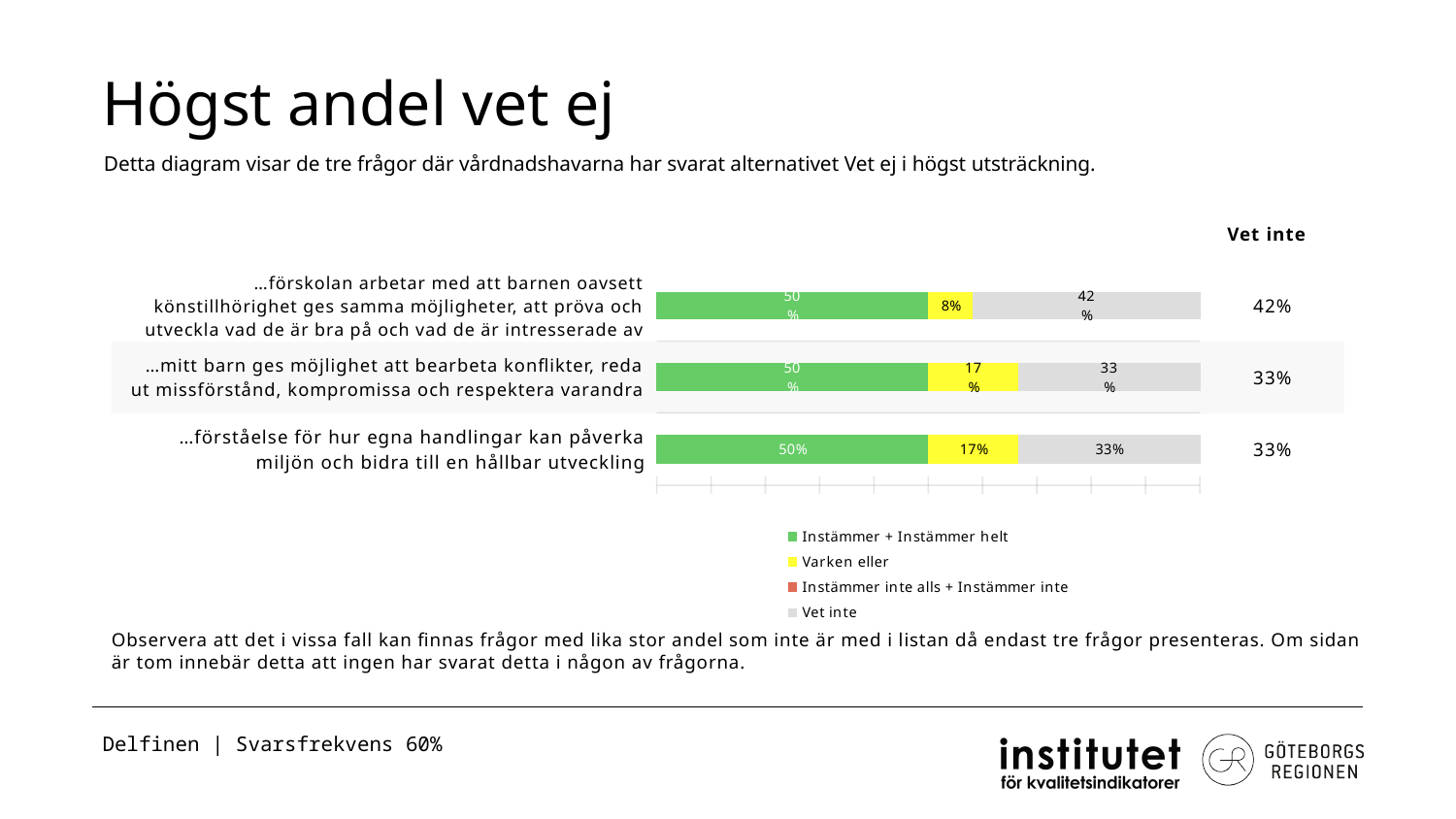
What type of chart is shown on the slide? Stacked bar chart What is the 'Vet inte' share for the top bar (…förskolan arbetar med att barnen oavsett könstillhörighet ges samma möjligheter…)? 42% What is the 'Varken eller' value for the top bar (…förskolan arbetar med att barnen oavsett könstillhörighet…)? 8% How many bars (questions) are plotted in the chart? 3 Which question has the highest 'Vet inte' share? …förskolan arbetar med att barnen oavsett könstillhörighet ges samma möjligheter, att pröva och utveckla vad de är bra på och vad de är intresserade av What is the difference between the 'Vet inte' share of the top bar and the middle bar? 9 percentage points What is the total of the three labelled segments in the middle bar (…mitt barn ges möjlighet att bearbeta konflikter…)? 100% Is the 'Varken eller' value larger for the top bar or the bottom bar? Bottom bar What is the heading of the column of values shown to the right of the bars? Vet inte How many series does the legend list? 4 What is the 'Instämmer + Instämmer helt' value for the bottom bar (…förståelse för hur egna handlingar kan påverka miljön…)? 50% What is the 'Varken eller' value for the middle bar (…mitt barn ges möjlighet att bearbeta konflikter…)? 17%